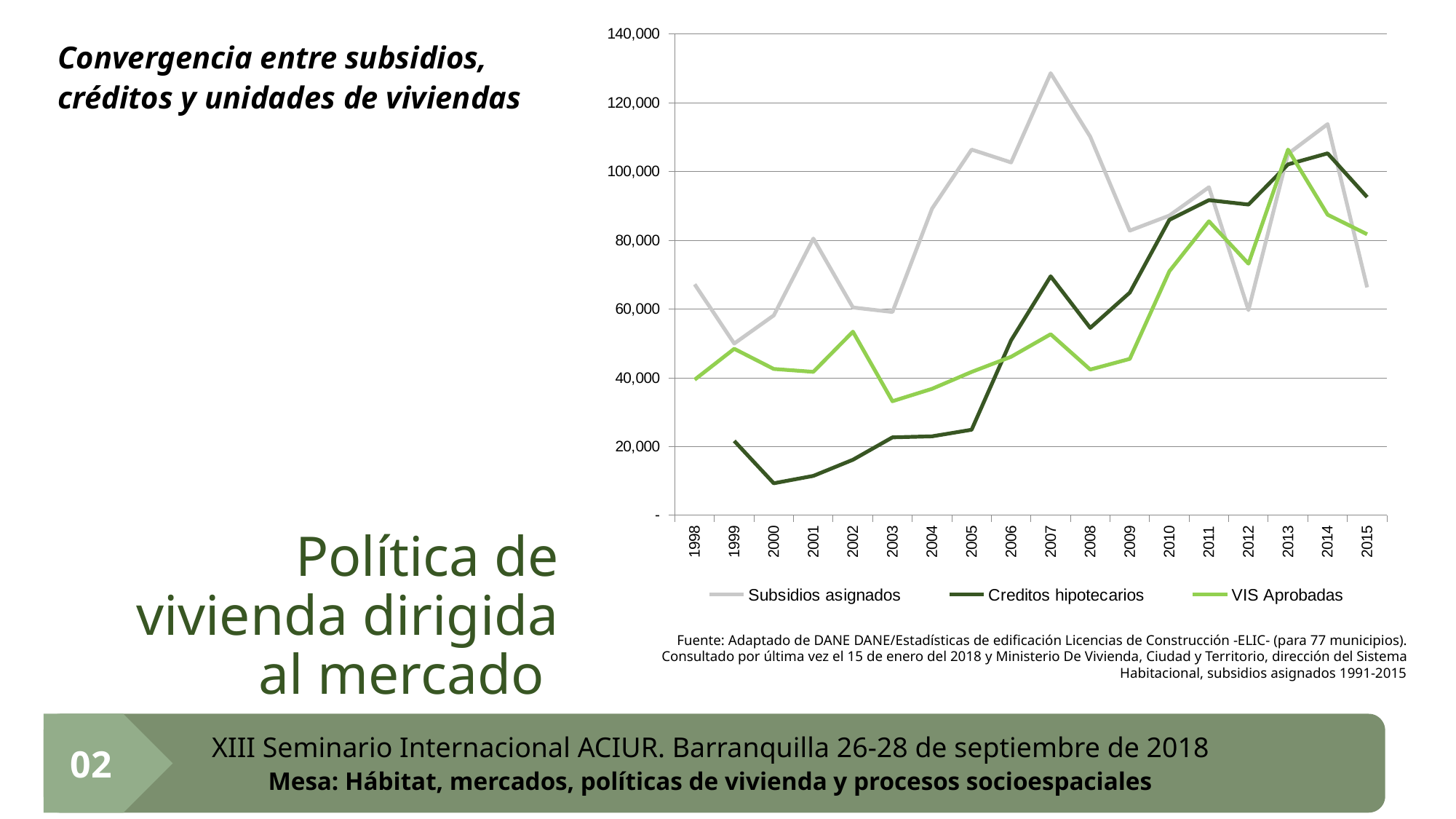
In which year does the Creditos hipotecarios series reach its lowest value? 2000 Which series has the lowest value in 2003? Creditos hipotecarios How many series does the chart legend list? 3 Is the value for VIS Aprobadas in 2003 greater or less than 40,000? less In 2015, which is larger: Creditos hipotecarios or Subsidios asignados? Creditos hipotecarios In which year does the Subsidios asignados series reach its highest value? 2007 Which series has the highest value in 2007? Subsidios asignados Is the value for Creditos hipotecarios in 2000 greater or less than 20,000? less How many years are plotted along the x axis of the chart? 18 What kind of chart is shown on the slide? Line chart Does the Creditos hipotecarios series rise or fall between 2005 and 2007? Rise Is the value for Subsidios asignados in 2007 greater or less than 120,000? greater